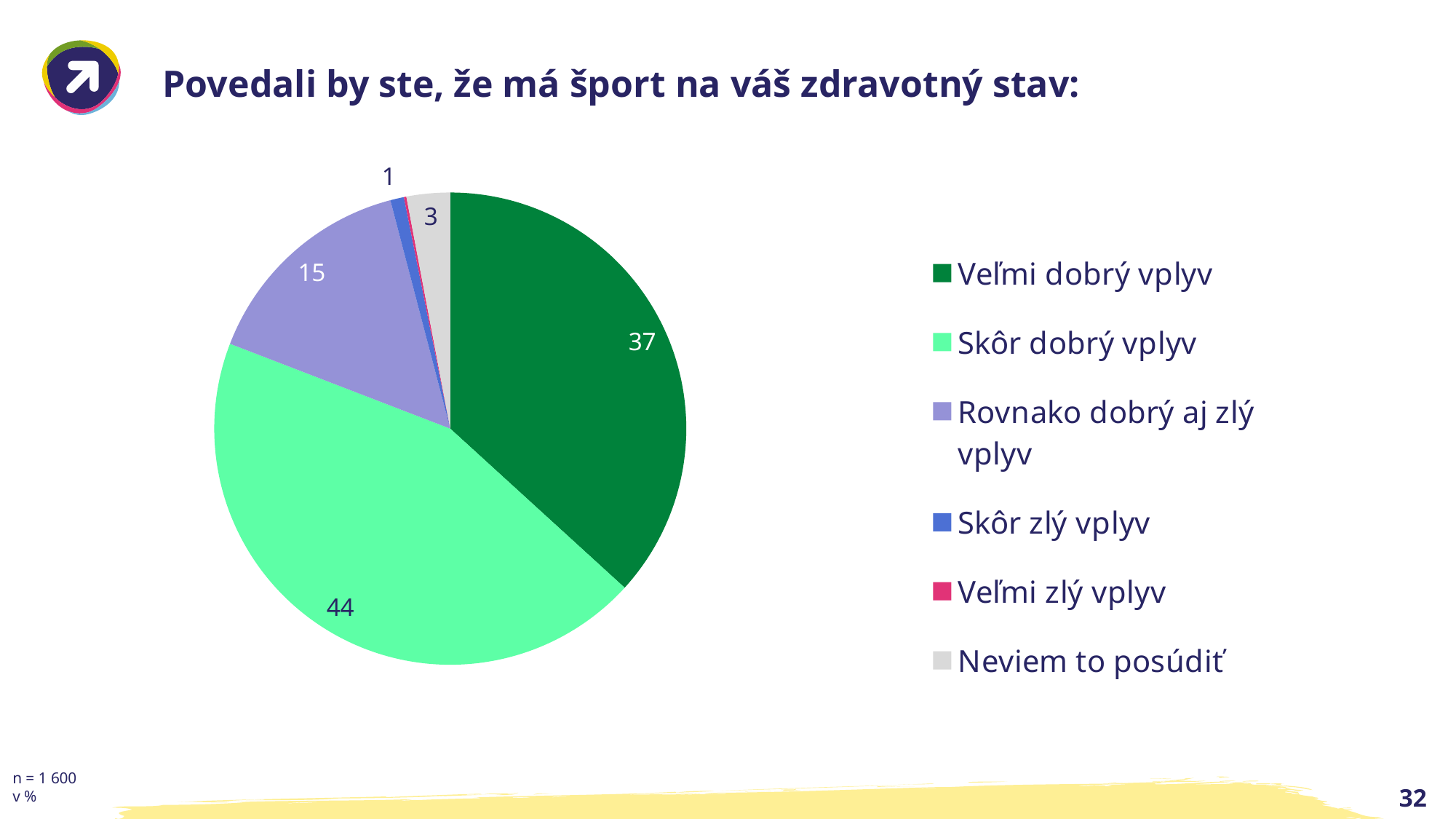
Which category has the largest slice of the pie? Skôr dobrý vplyv What is the difference between the values for "Rovnako dobrý aj zlý vplyv" and "Neviem to posúdiť"? 12 Which is larger, the value for "Veľmi dobrý vplyv" or the value for "Rovnako dobrý aj zlý vplyv"? Veľmi dobrý vplyv What is the value for "Skôr dobrý vplyv"? 44 What is the value for "Skôr zlý vplyv"? 1 What is the difference between the values for "Skôr dobrý vplyv" and "Veľmi dobrý vplyv"? 7 What is the value for "Veľmi dobrý vplyv"? 37 What is the value for "Neviem to posúdiť"? 3 What kind of chart is shown on the slide? pie chart What is the value for "Rovnako dobrý aj zlý vplyv"? 15 How many entries does the legend list? 6 What is the title of the slide above the chart? Povedali by ste, že má šport na váš zdravotný stav: